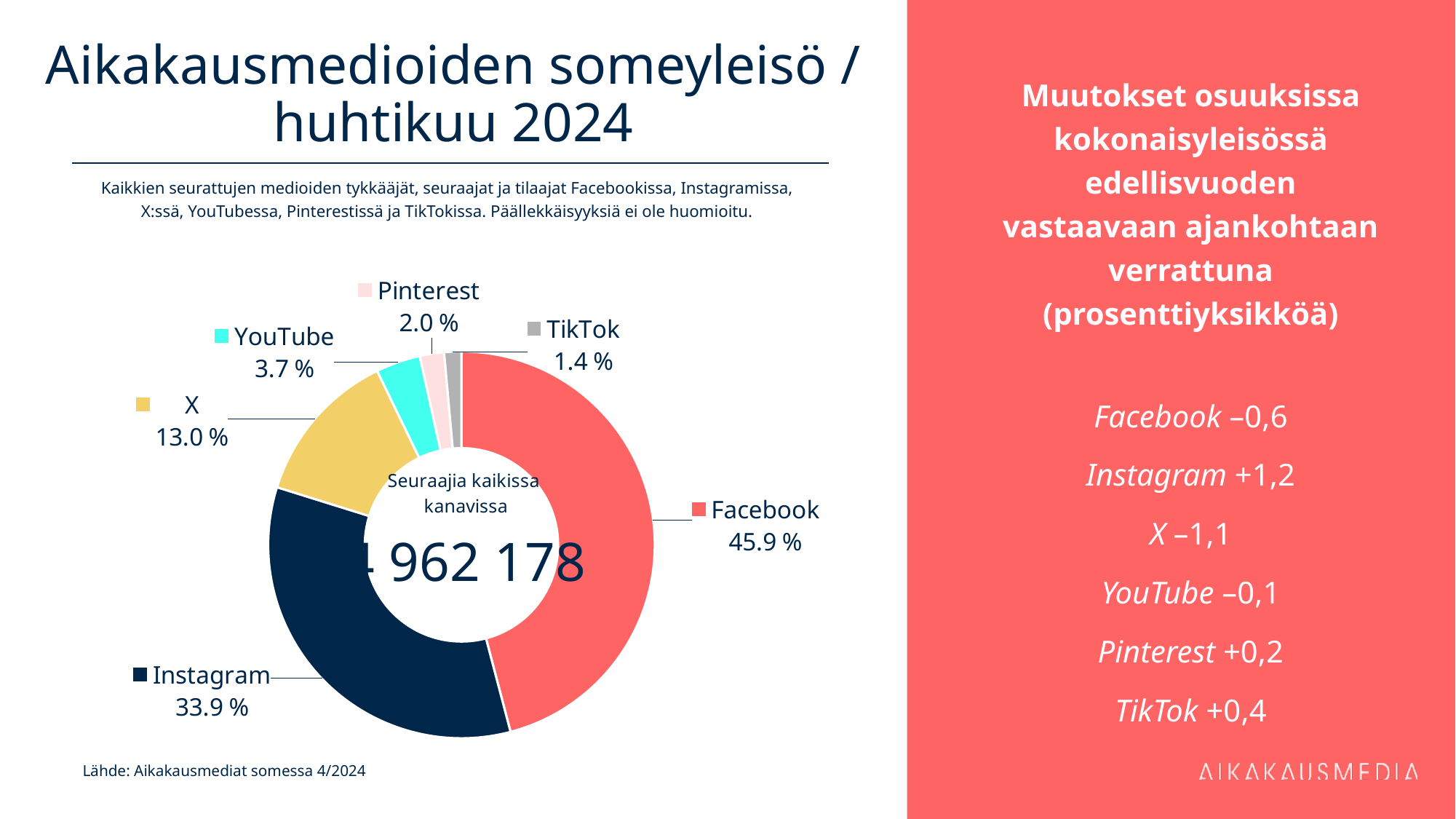
Which channel has the largest share of the audience? Facebook What share of the social media audience does Instagram have? 33.9 % What share of the social media audience does Pinterest have? 2.0 % What share of the social media audience does TikTok have? 1.4 % What share of the social media audience does YouTube have? 3.7 % What share of the social media audience does X have? 13.0 % What kind of chart is shown on the slide? Doughnut (pie) chart Which has a larger share, X or YouTube? X What share of the social media audience does Facebook have? 45.9 % How many percentage points larger is Facebook's share than Instagram's share? 12.0 % How many channels (slices) are shown in the chart? 6 Which channel has the smallest share of the audience? TikTok